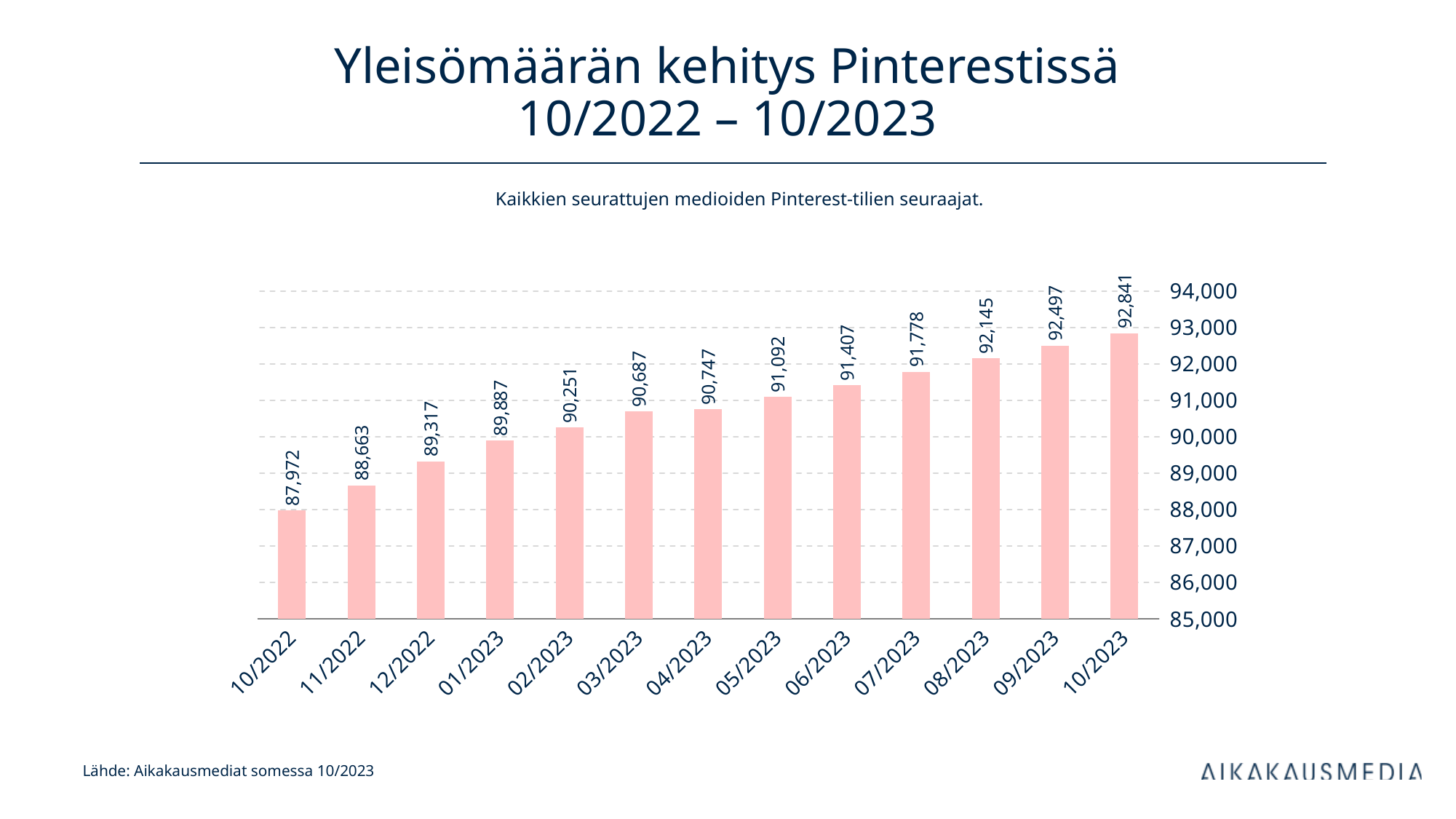
What is the value for 08/2023? 92,145 Which is larger, the value for 12/2022 or the value for 01/2023? 01/2023 How many months are shown on the x axis? 13 What is the value for 04/2023? 90,747 Which month has the highest value? 10/2023 What kind of chart is shown on the slide? Bar chart Is the value for 05/2023 greater or less than 91,000? greater What is the value for 10/2022? 87,972 Do the values rise or fall from 10/2022 to 10/2023? Rise Which month has the lowest value? 10/2022 What is the difference between the values for 10/2023 and 10/2022? 4,869 What is the difference between the values for 03/2023 and 02/2023? 436